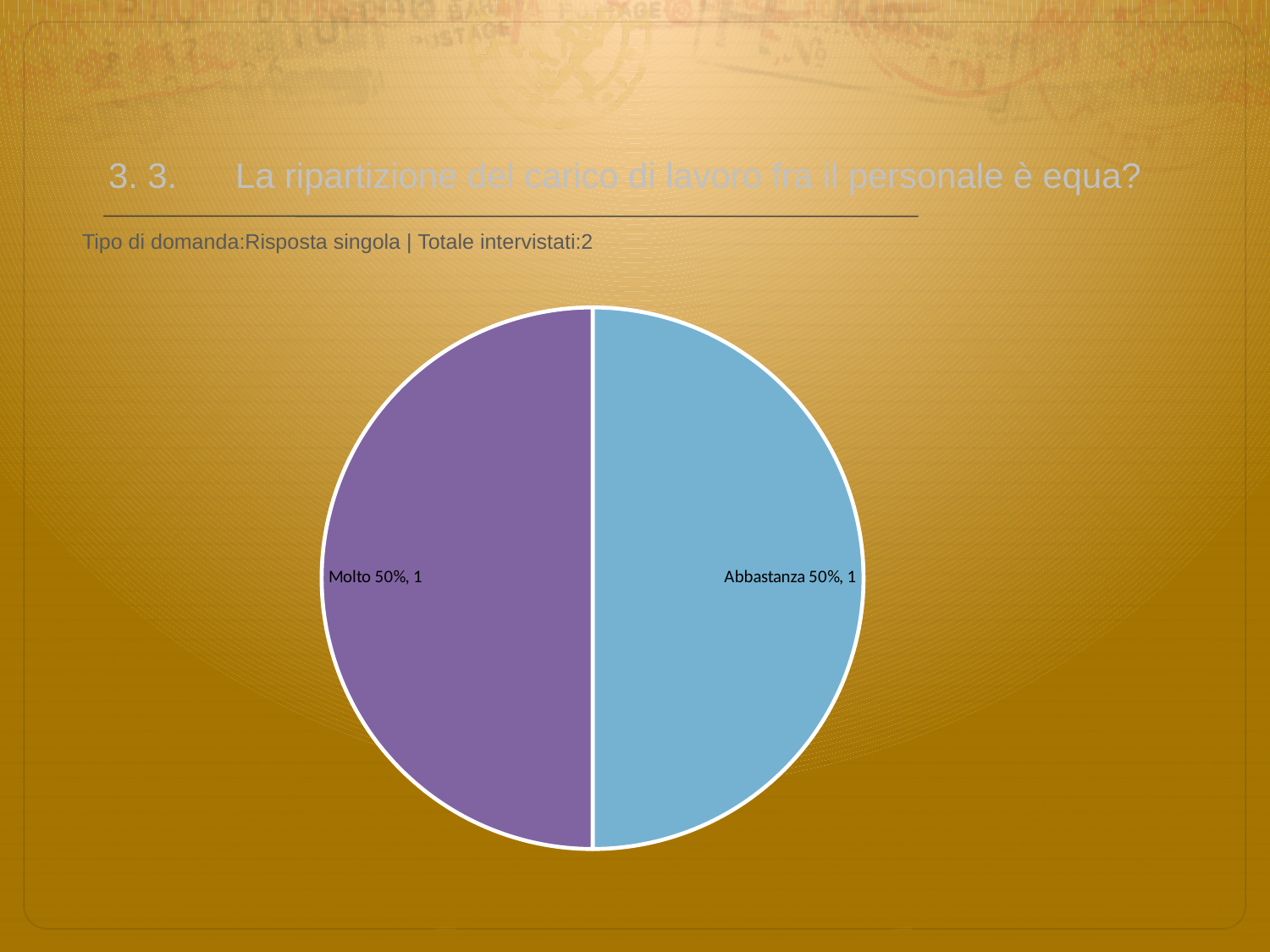
What share of the pie does the "Molto" slice represent? 50% What is the total of the values shown for the two slices? 2 What colour is the "Molto" slice? purple What is the count value shown for the "Molto" slice? 1 What is the count value shown for the "Abbastanza" slice? 1 What is the difference between the values for "Molto" and "Abbastanza"? 0 What colour is the "Abbastanza" slice? light blue What share of the pie does the "Abbastanza" slice represent? 50% How many slices does the pie chart have? 2 What kind of chart is shown on the slide? pie chart